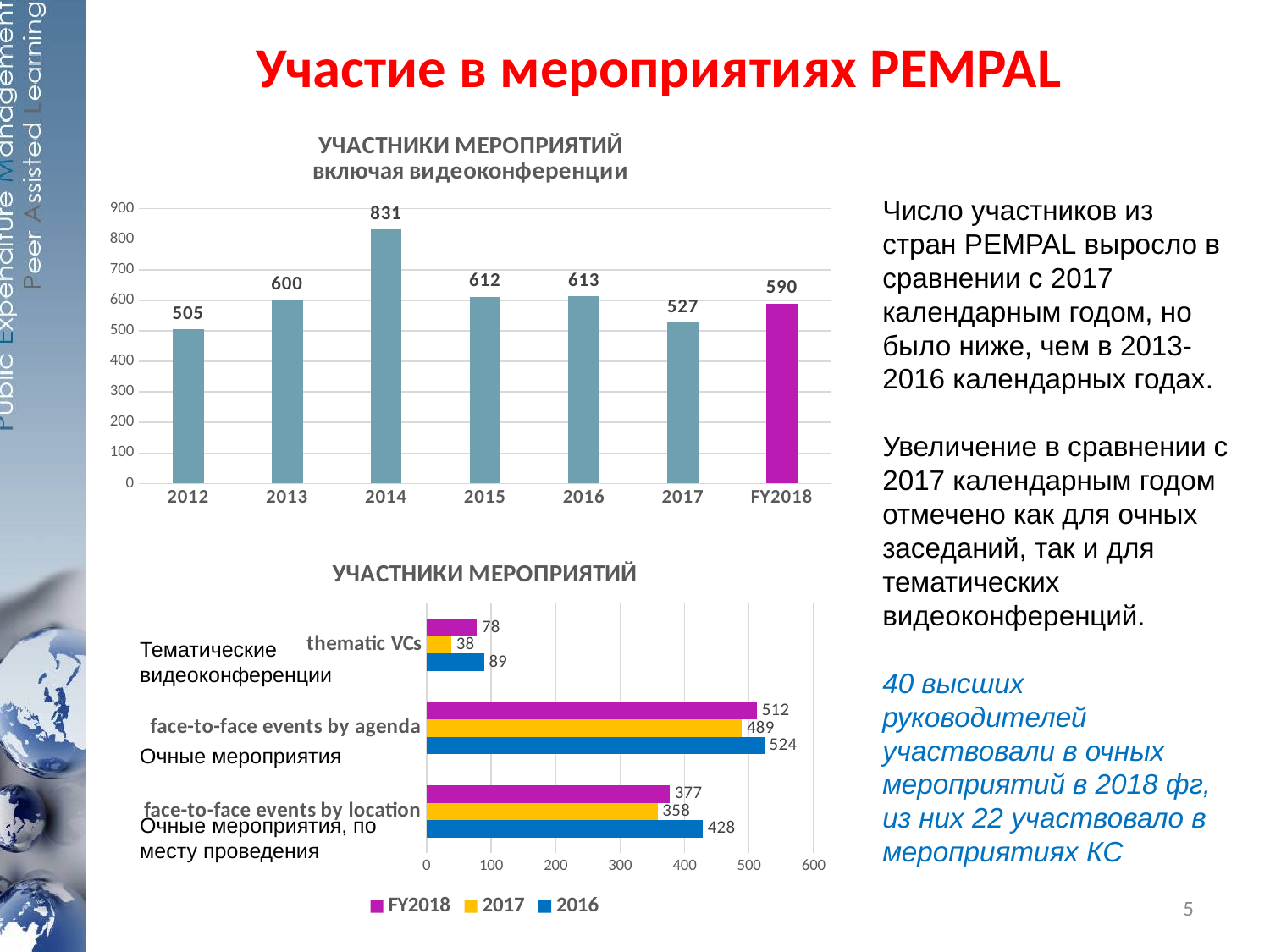
In the bottom chart 'УЧАСТНИКИ МЕРОПРИЯТИЙ', what is the difference between the 2016 and 2017 values for face-to-face events by location? 70 In the top chart 'УЧАСТНИКИ МЕРОПРИЯТИЙ включая видеоконференции', which year has the highest value? 2014 In the top chart 'УЧАСТНИКИ МЕРОПРИЯТИЙ включая видеоконференции', which bar is shown in a different colour (magenta) from the others? FY2018 In the top chart 'УЧАСТНИКИ МЕРОПРИЯТИЙ включая видеоконференции', which year has the lowest value? 2012 In the bottom chart 'УЧАСТНИКИ МЕРОПРИЯТИЙ', what is the FY2018 value for face-to-face events by agenda? 512 What type of chart is the bottom chart 'УЧАСТНИКИ МЕРОПРИЯТИЙ'? bar chart In the top chart 'УЧАСТНИКИ МЕРОПРИЯТИЙ включая видеоконференции', how many years are shown on the x axis? 7 In the bottom chart 'УЧАСТНИКИ МЕРОПРИЯТИЙ', which is larger for face-to-face events by location: the 2016 value or the FY2018 value? 2016 In the bottom chart 'УЧАСТНИКИ МЕРОПРИЯТИЙ', what is the 2017 value for thematic VCs? 38 In the bottom chart 'УЧАСТНИКИ МЕРОПРИЯТИЙ', how many series does the legend list? 3 In the top chart 'УЧАСТНИКИ МЕРОПРИЯТИЙ включая видеоконференции', what is the difference between FY2018 and 2017? 63 In the top chart 'УЧАСТНИКИ МЕРОПРИЯТИЙ включая видеоконференции', what is the value for 2014? 831